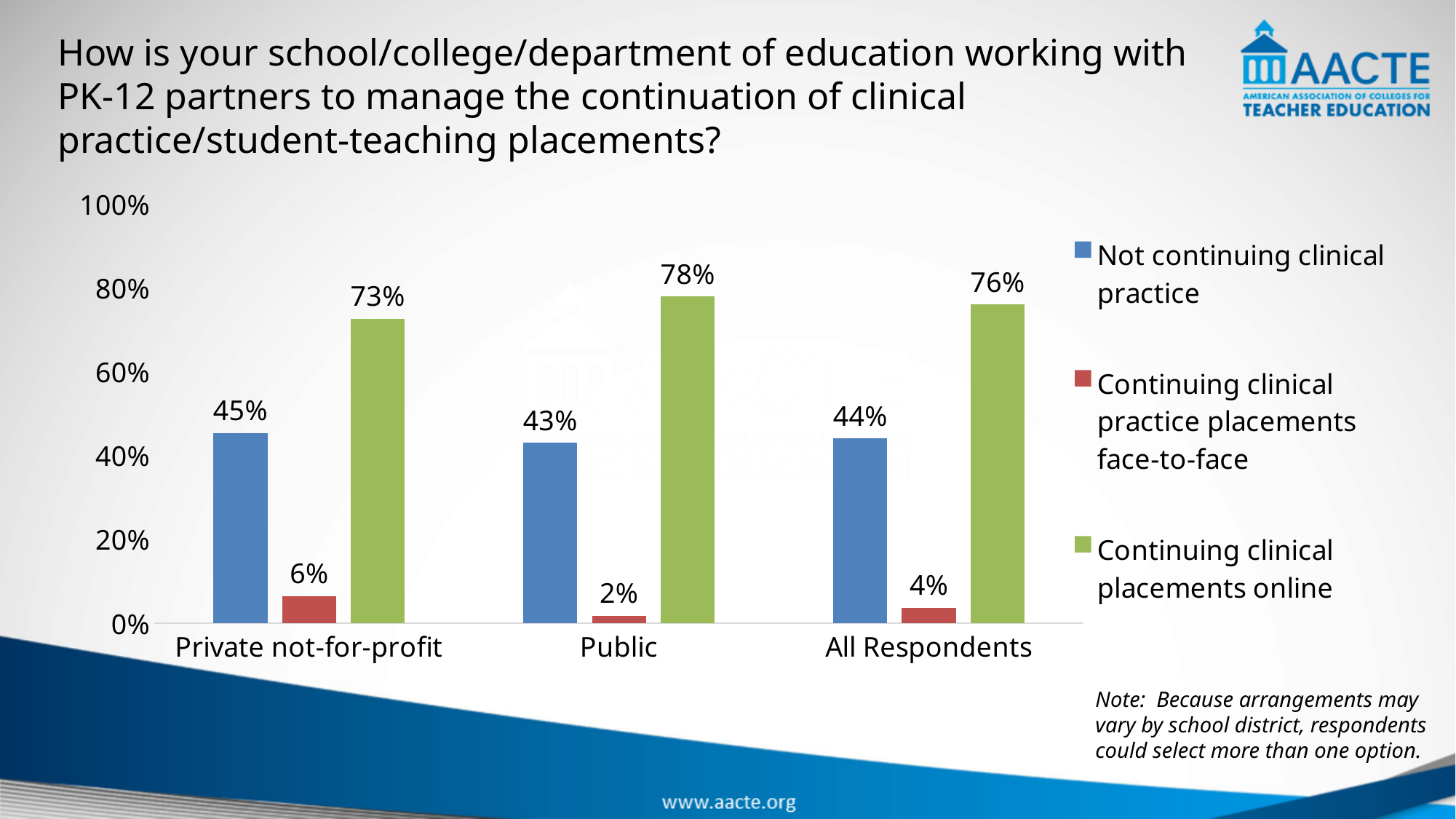
Is the value for 'Not continuing clinical practice' among Public respondents greater or less than 60%? less Which category has the highest value for 'Continuing clinical placements online'? Public What is the difference between the 'Continuing clinical placements online' values for Public and Private not-for-profit? 5% What kind of chart is shown on the slide? Bar chart What is the value for 'Not continuing clinical practice' among Private not-for-profit respondents? 45% Which category has the lowest value for 'Continuing clinical practice placements face-to-face'? Public What percentage of All Respondents are continuing clinical practice placements face-to-face? 4% What percentage of Public respondents are continuing clinical placements online? 78% What colour represents 'Continuing clinical placements online' in the chart? Green How many categories are shown on the x axis? 3 How many series does the legend list? 3 Which is larger for Private not-for-profit: 'Not continuing clinical practice' or 'Continuing clinical placements online'? Continuing clinical placements online